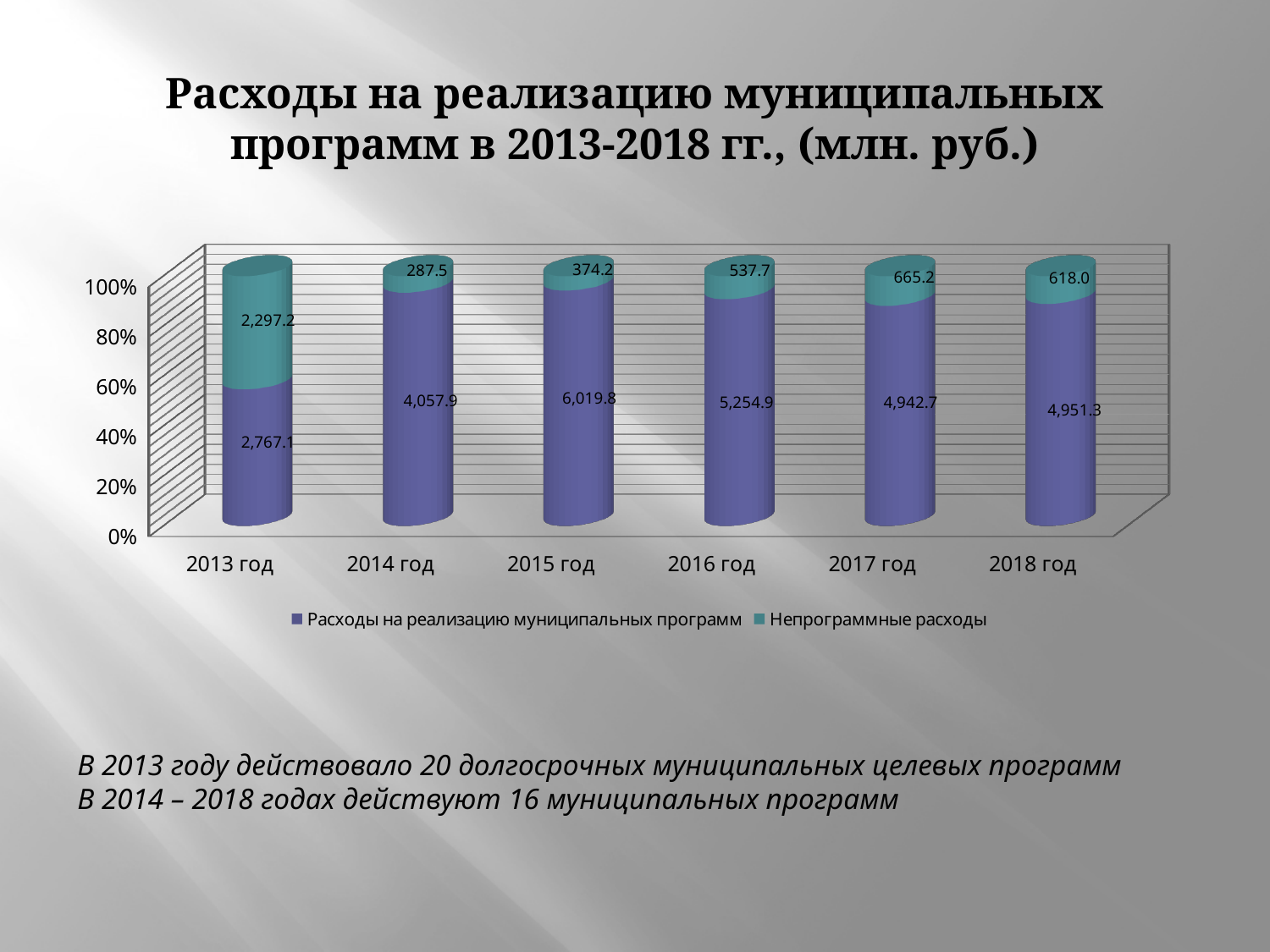
What is the value of "Расходы на реализацию муниципальных программ" for 2015 год? 6,019.8 What kind of chart is shown on the slide? Stacked bar chart What is the value of "Непрограммные расходы" for 2018 год? 618.0 How many series does the chart legend list? 2 What is the difference between the "Расходы на реализацию муниципальных программ" values for 2015 год and 2014 год? 1,961.9 What is the total of the two series for 2013 год? 5,064.3 What is the difference between the "Непрограммные расходы" values for 2017 год and 2018 год? 47.2 How many years are shown on the x axis of the chart? 6 In which year is the value of "Расходы на реализацию муниципальных программ" the highest? 2015 год Which year has the larger value of "Расходы на реализацию муниципальных программ": 2016 год or 2017 год? 2016 год What is the value of "Непрограммные расходы" for 2013 год? 2,297.2 In which year is the value of "Непрограммные расходы" the lowest? 2014 год